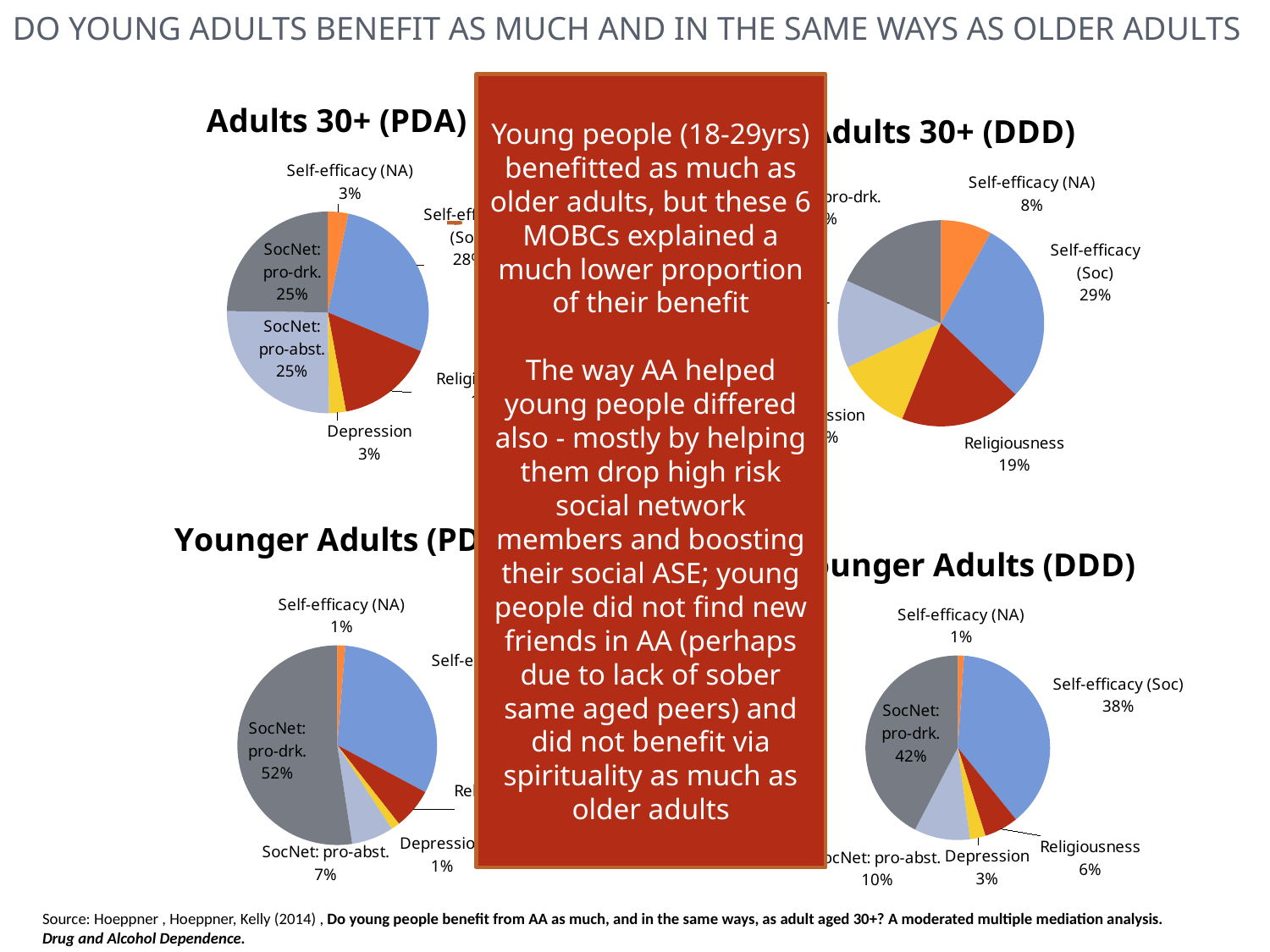
In the bottom-left chart (Younger Adults, PDA), which slice is the largest? SocNet: pro-drk. In the Adults 30+ (PDA) chart, what share does Depression have? 3% In the Adults 30+ (PDA) chart, what share does SocNet: pro-drk. have? 25% In the bottom-left chart (Younger Adults, PDA), what share does SocNet: pro-drk. have? 52% In the top-right chart (Adults 30+, DDD), what share does Religiousness have? 19% In the bottom-right chart (Younger Adults, DDD), what share does Self-efficacy (Soc) have? 38% In the bottom-right chart (Younger Adults, DDD), which slice is the largest? SocNet: pro-drk. In the bottom-right chart (Younger Adults, DDD), which slice is the smallest? Self-efficacy (NA) What kind of charts are shown on the slide? Pie charts In the bottom-right chart (Younger Adults, DDD), what is the difference between the SocNet: pro-drk. share and the Self-efficacy (Soc) share? 4 percentage points Which is larger: the SocNet: pro-drk. share in the Adults 30+ (PDA) chart or in the bottom-left Younger Adults (PDA) chart? Younger Adults (PDA) In the bottom-left chart (Younger Adults, PDA), what is the difference between the SocNet: pro-drk. share and the SocNet: pro-abst. share? 45 percentage points